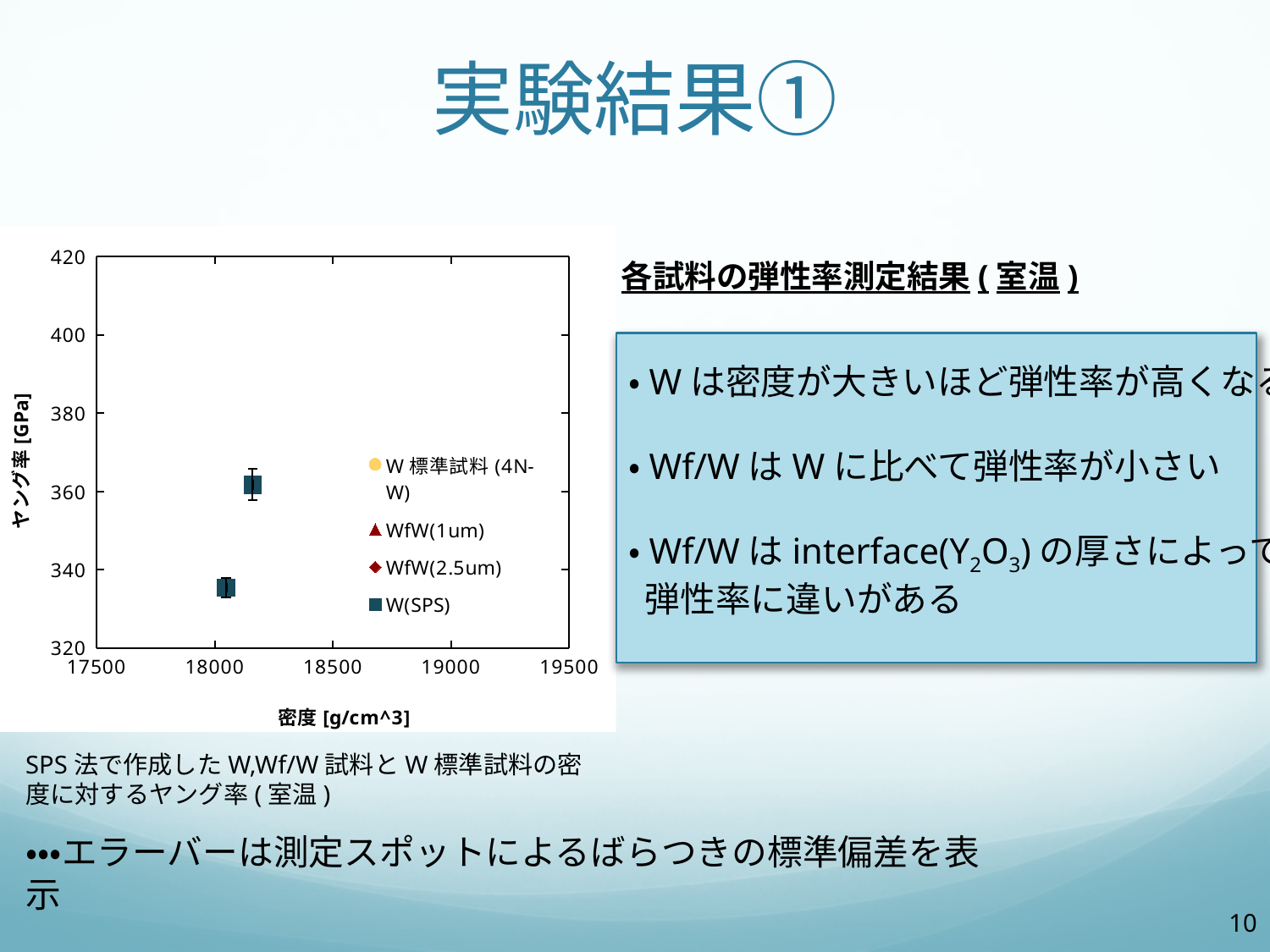
Is the density of the W(SPS) points greater or less than 18500 g/cm^3? less Is the Young's modulus of the lower W(SPS) point greater or less than 340 GPa? less Which of the two W(SPS) points has the higher Young's modulus, the one at lower density or the one at higher density? the one at higher density How many W(SPS) data points are plotted on the chart? 2 What is the label of the x axis of the chart? 密度 [g/cm^3] What is the maximum value shown on the y axis of the chart? 420 What kind of chart is shown on the slide? scatter chart What is the minimum value shown on the x axis of the chart? 17500 How many series does the chart legend list? 4 Is the Young's modulus of the upper W(SPS) point greater or less than 350 GPa? greater For the W(SPS) points, does the Young's modulus rise or fall as density increases? rise